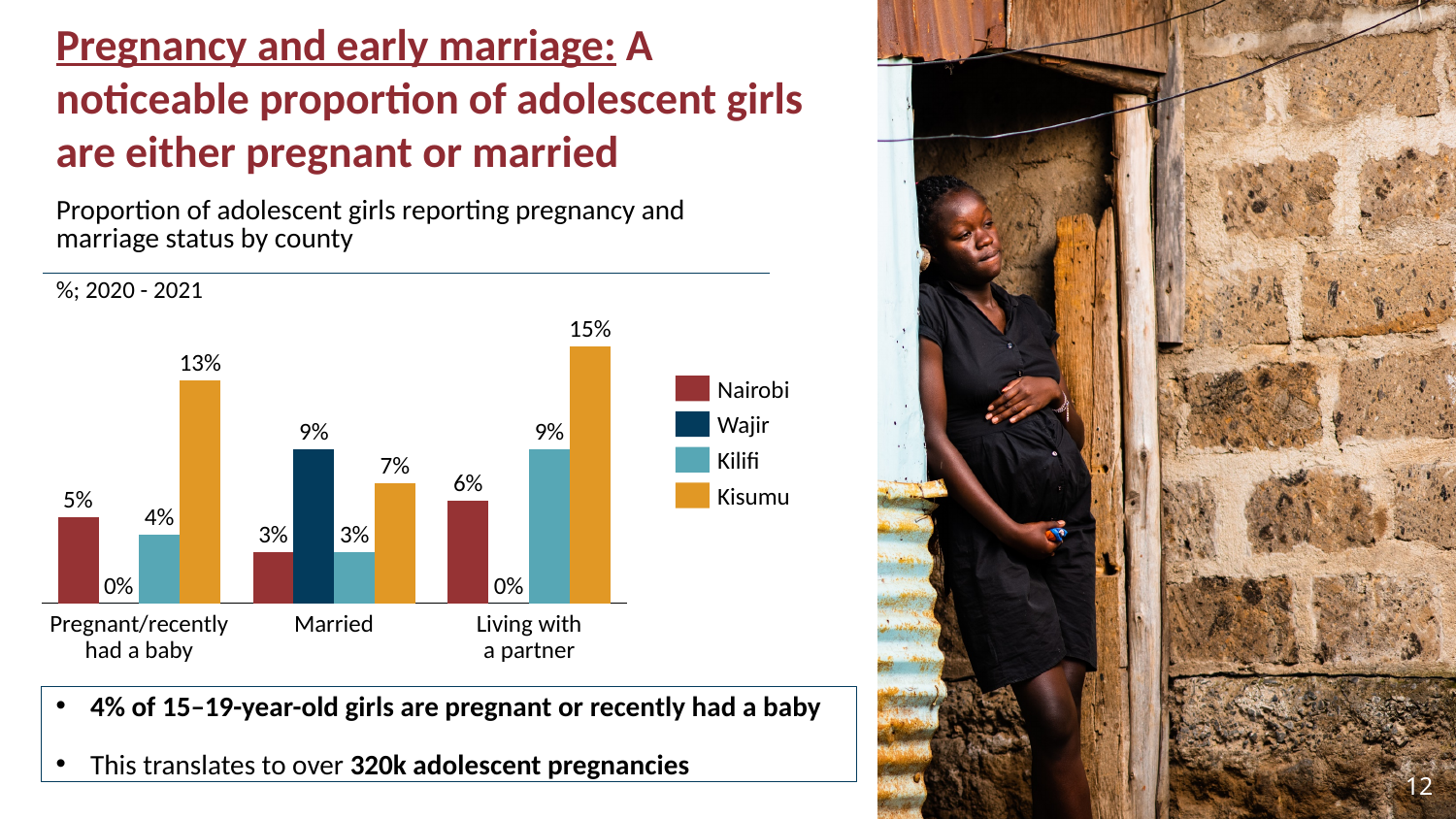
What is the difference between Kisumu and Nairobi in the 'Pregnant/recently had a baby' category? 8% What is the value for Wajir in the 'Living with a partner' category? 0% How many series does the legend list? 4 What is the value for Kisumu in the 'Pregnant/recently had a baby' category? 13% Which county has the highest value in the 'Living with a partner' category? Kisumu How many categories are shown on the x axis? 3 Which county is shown in dark blue in the legend? Wajir What is the value for Kilifi in the 'Living with a partner' category? 9% What kind of chart is shown on the slide? Bar chart What is the value for Wajir in the 'Married' category? 9% Which county has the lowest value in the 'Married' category? Nairobi and Kilifi (3%) Which is larger: Nairobi's value for 'Living with a partner' or Nairobi's value for 'Married'? Living with a partner